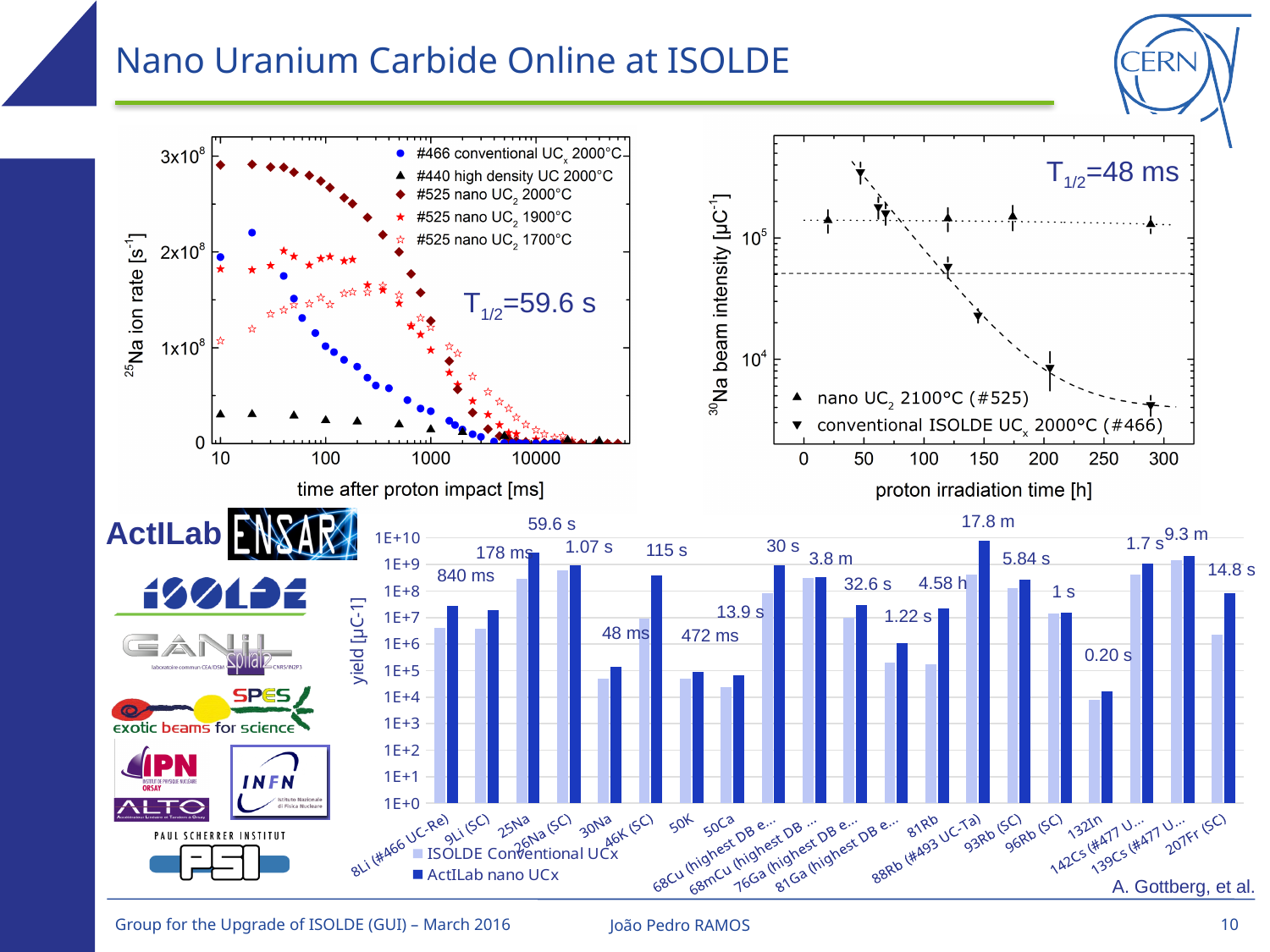
In the top-right chart of 30Na beam intensity versus proton irradiation time, does the beam intensity for conventional ISOLDE UCx 2000°C (#466) rise or fall with increasing irradiation time? fall In the top-left chart of 25Na ion rate versus time after proton impact, what half-life value is annotated on the plot? T1/2=59.6 s In the top-left chart of 25Na ion rate versus time after proton impact, which series has the highest ion rate at 10 ms? #525 nano UC2 2000°C In the top-left chart of 25Na ion rate versus time after proton impact, which series has the lowest ion rate across the plotted range? #440 high density UC 2000°C What kind of chart is the bottom chart showing yield [µC-1] per isotope? bar chart In the bottom yield bar chart, is the ActILab nano UCx yield for 25Na greater or less than 1E+9? greater In the bottom yield bar chart, which series has the larger yield for 25Na, ISOLDE Conventional UCx or ActILab nano UCx? ActILab nano UCx In the top-right chart of 30Na beam intensity versus proton irradiation time, is the value for conventional ISOLDE UCx 2000°C (#466) at about 290 h greater or less than 10^4 µC^-1? less In the top-right chart of 30Na beam intensity versus proton irradiation time, how many series does the legend list? 2 In the top-left chart of 25Na ion rate versus time after proton impact, how many series does the legend list? 5 In the bottom yield bar chart, what half-life is labelled above the 88Rb (#493 UC-Ta) bars? 17.8 m In the top-right chart of 30Na beam intensity versus proton irradiation time, is the value for nano UC2 2100°C (#525) at about 120 h greater or less than 10^5 µC^-1? greater